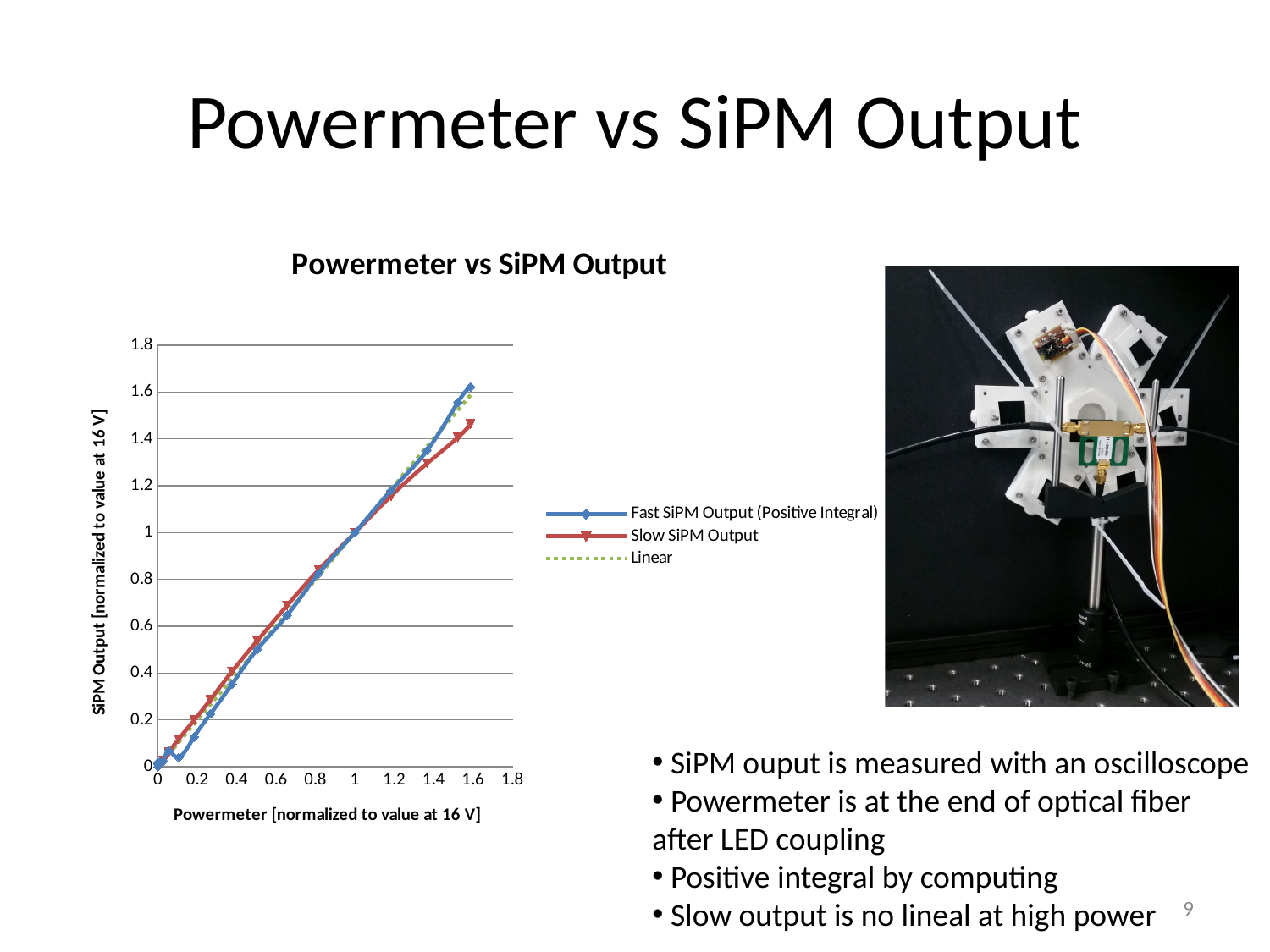
Is the Slow SiPM Output value at the highest Powermeter point greater or less than 1.2? greater What is the label of the x axis of the chart? Powermeter [normalized to value at 16 V] Is the Slow SiPM Output value at Powermeter 0.4 greater or less than 0.6? less Is the Fast SiPM Output (Positive Integral) value at the highest Powermeter point greater or less than 1.4? greater Do the values of the Slow SiPM Output series rise or fall along the x axis? rise Do the values of the Fast SiPM Output (Positive Integral) series rise or fall as the Powermeter value increases? rise At the highest Powermeter value plotted, which series is higher: Fast SiPM Output (Positive Integral) or Slow SiPM Output? Fast SiPM Output (Positive Integral) What is the title of the chart? Powermeter vs SiPM Output What kind of chart is shown on the slide? line chart What is the highest tick value shown on the y axis of the chart? 1.8 How many series does the chart legend list? 3